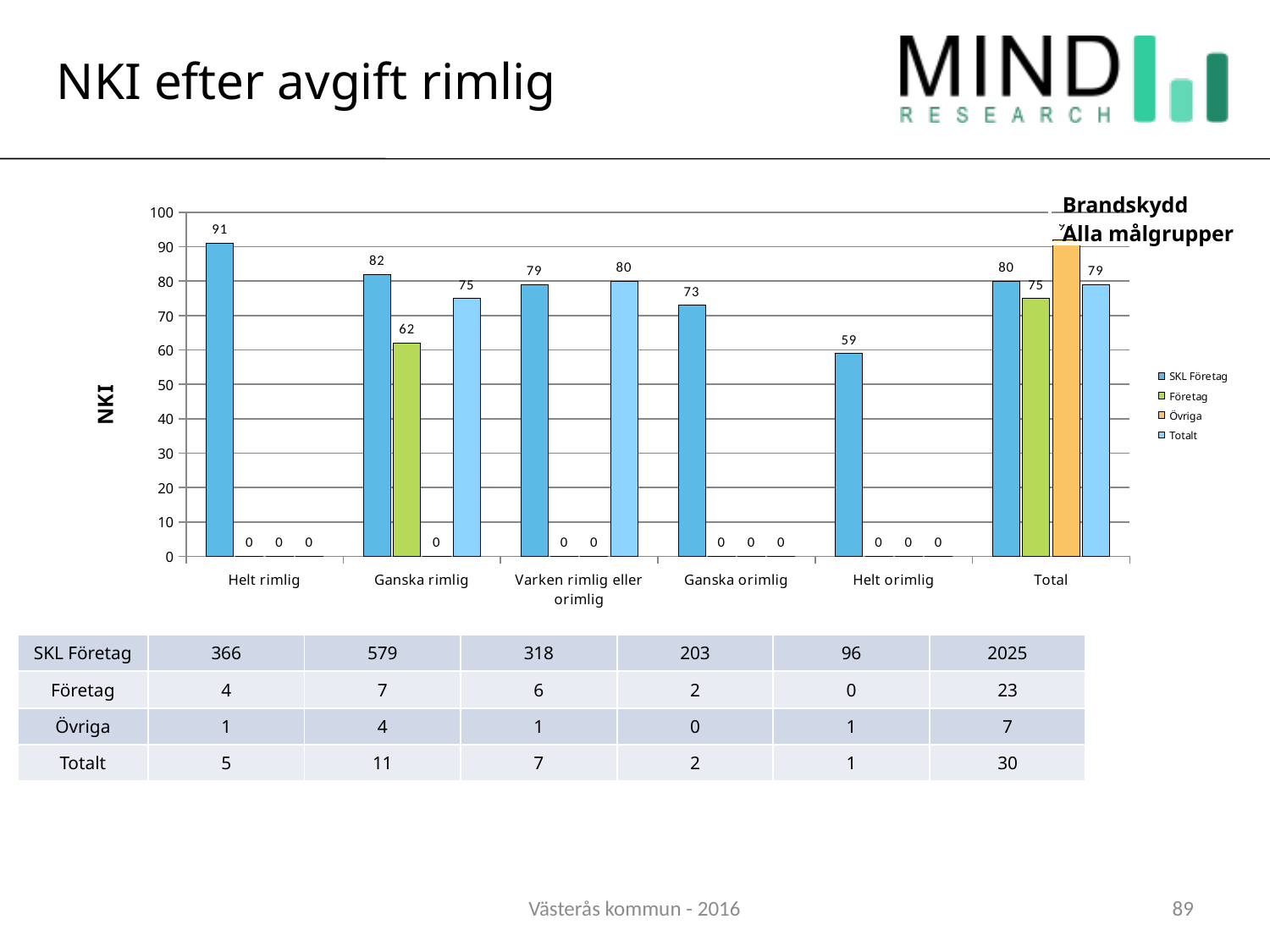
What is the difference between the SKL Företag values for Helt rimlig and Helt orimlig? 32 What is the NKI value for SKL Företag in the Helt rimlig category? 91 What is the NKI value for SKL Företag in the Ganska orimlig category? 73 What is the difference between the SKL Företag value and the Totalt value in the Ganska rimlig category? 7 What type of chart is shown on the slide? Bar chart What is the NKI value for Företag in the Ganska rimlig category? 62 In which category does SKL Företag have its lowest NKI value? Helt orimlig What is the NKI value for Totalt in the Varken rimlig eller orimlig category? 80 How many categories are shown on the x axis of the chart? 6 In which category does SKL Företag have its highest NKI value? Helt rimlig In the Ganska rimlig category, which is larger: the SKL Företag value or the Företag value? SKL Företag How many series does the chart legend list? 4